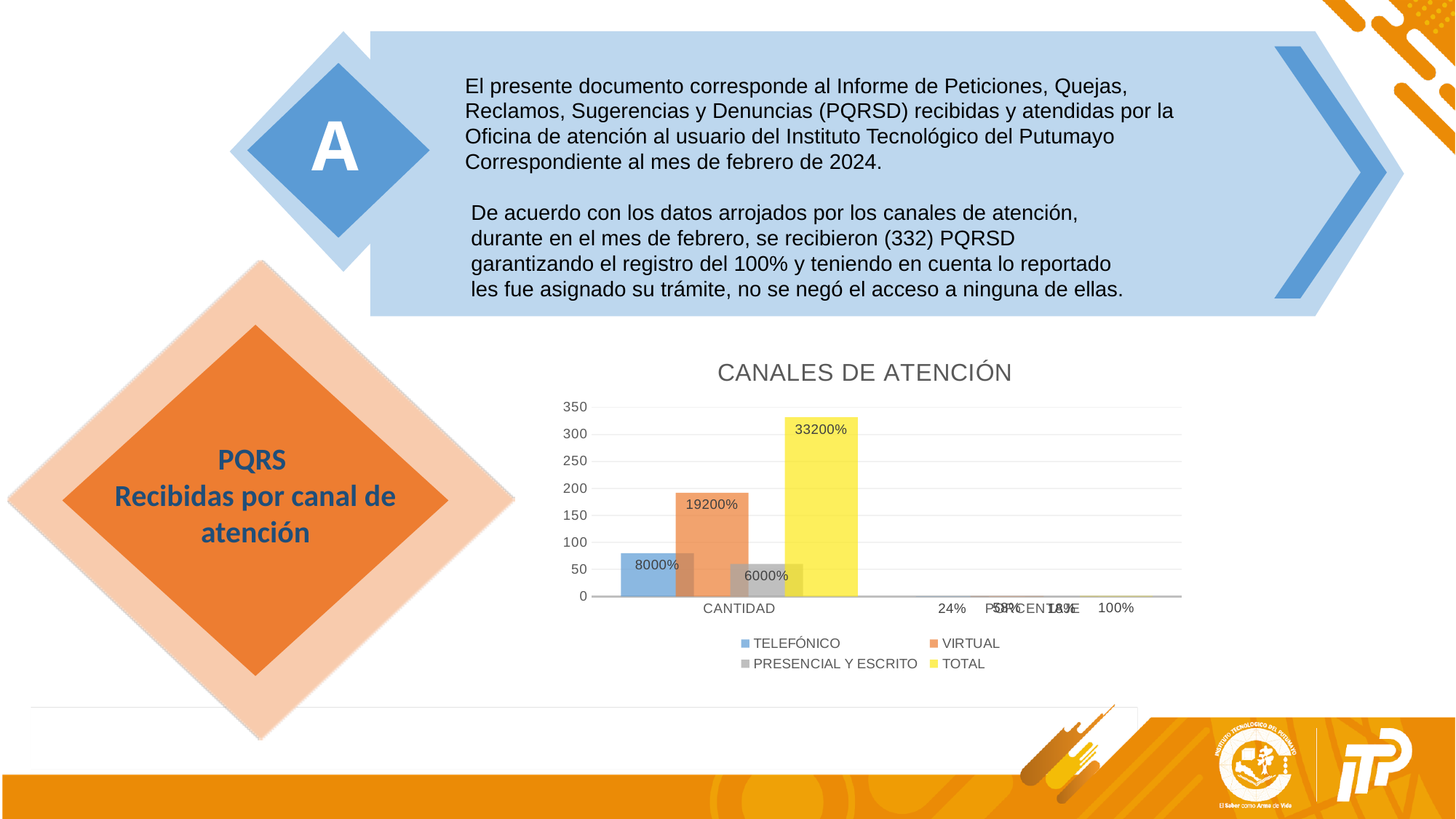
Is the VIRTUAL bar in the CANTIDAD group greater or less than 150 on the axis? greater In the CANTIDAD group, which bar is taller: TELEFÓNICO or VIRTUAL? VIRTUAL How many series does the legend of the CANALES DE ATENCIÓN chart list? 4 Which series has the shortest bar in the CANTIDAD group? PRESENCIAL Y ESCRITO What is the data label shown for TELEFÓNICO in the PORCENTAJE group? 24% What is the data label on the VIRTUAL bar in the CANTIDAD group? 19200% What is the title of the chart? CANALES DE ATENCIÓN Which series has the tallest bar in the CANTIDAD group? TOTAL What kind of chart is shown under the title CANALES DE ATENCIÓN? bar chart What is the data label on the TOTAL bar in the CANTIDAD group? 33200% What is the data label on the TELEFÓNICO bar in the CANTIDAD group? 8000% What is the data label on the PRESENCIAL Y ESCRITO bar in the CANTIDAD group? 6000%